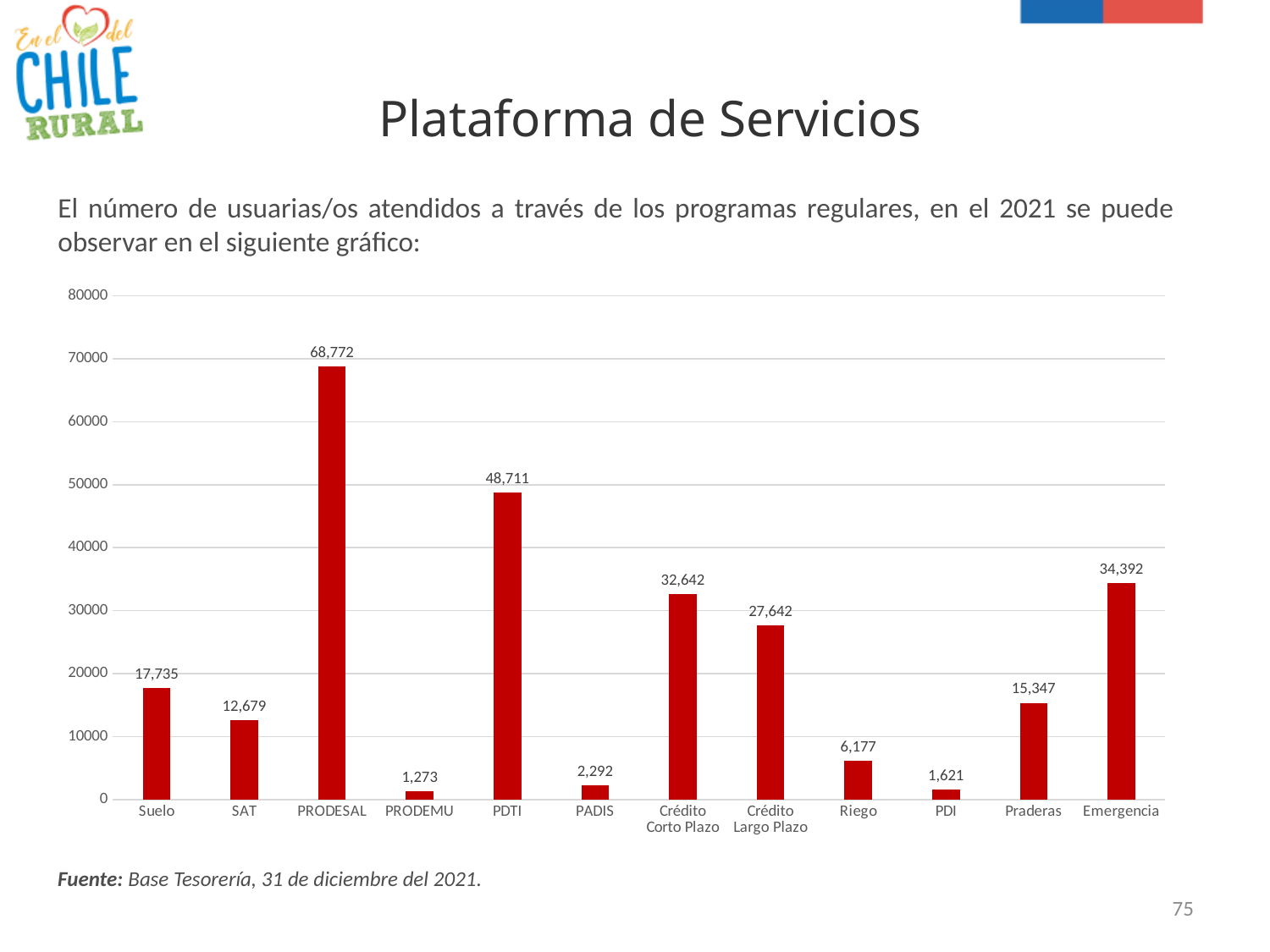
What kind of chart is shown on the slide? bar chart Which category has the lowest value? PRODEMU What is the difference between the values for PDTI and Crédito Corto Plazo? 16,069 How many categories are shown on the x axis? 12 Which is larger, the value for Suelo or the value for Praderas? Suelo What is the value for Crédito Largo Plazo? 27,642 Which category has the highest value? PRODESAL What is the value for Emergencia? 34,392 What is the value for PRODESAL? 68,772 Is the value for Riego greater or less than 10000? less What is the value for PADIS? 2,292 What is the difference between the values for Crédito Corto Plazo and Crédito Largo Plazo? 5,000